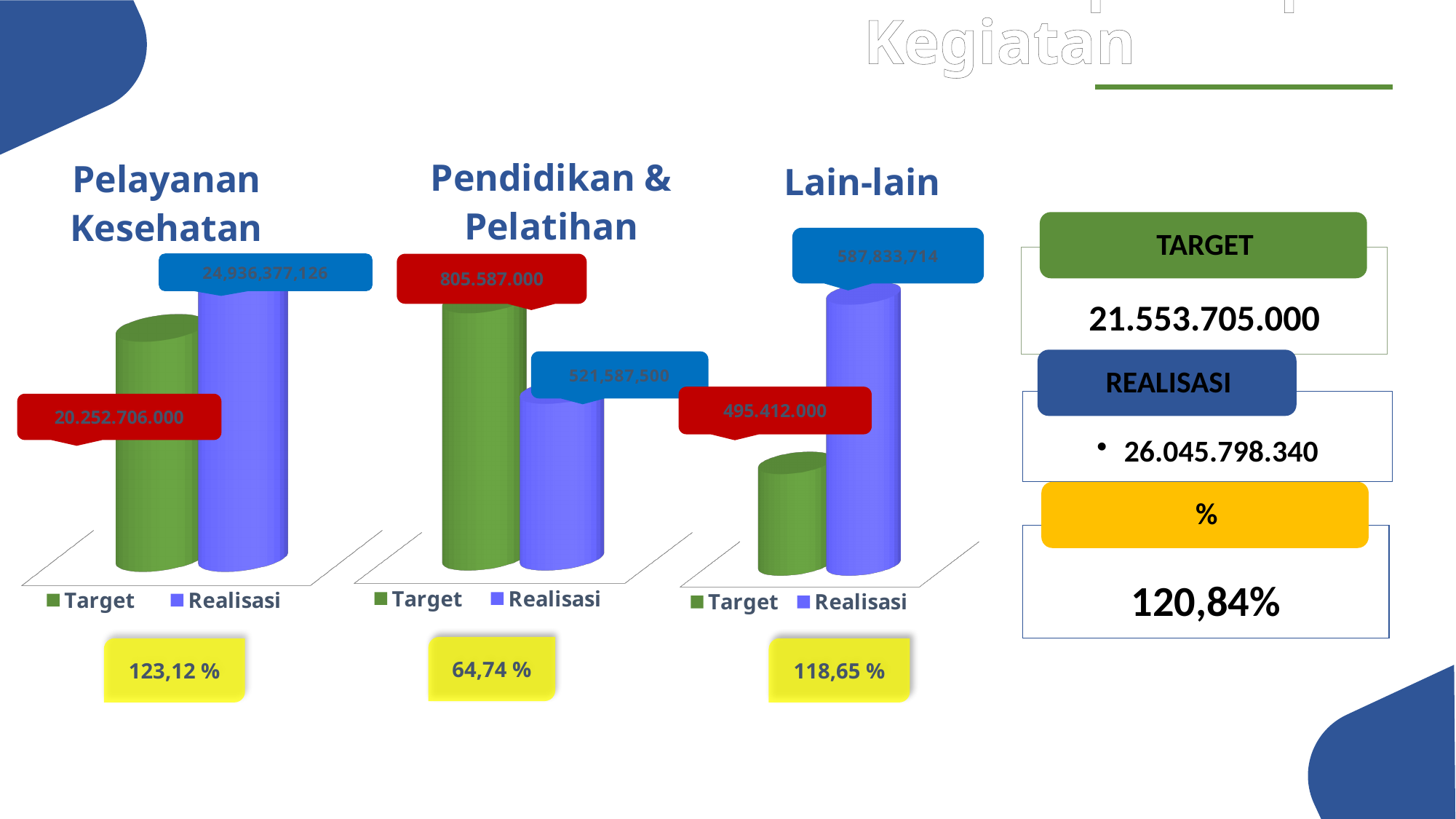
In the Lain-lain chart, what is the Target value? 495.412.000 In the Pelayanan Kesehatan chart, what is the Realisasi value? 24,936,377,126 In the Pendidikan & Pelatihan chart, what colour are the Target bars? Green In the Pendidikan & Pelatihan chart, which is larger, Target or Realisasi? Target In the Pelayanan Kesehatan chart, which is larger, Target or Realisasi? Realisasi In the Pelayanan Kesehatan chart, what is the Target value? 20.252.706.000 How many series does the legend of the Pelayanan Kesehatan chart list? 2 In the Lain-lain chart, what is the difference between Realisasi and Target? 92,421,714 What kind of chart is the Lain-lain chart? Bar chart In the Lain-lain chart, what is the Realisasi value? 587,833,714 In the Pendidikan & Pelatihan chart, what is the Realisasi value? 521,587,500 In the Pendidikan & Pelatihan chart, what is the Target value? 805.587.000